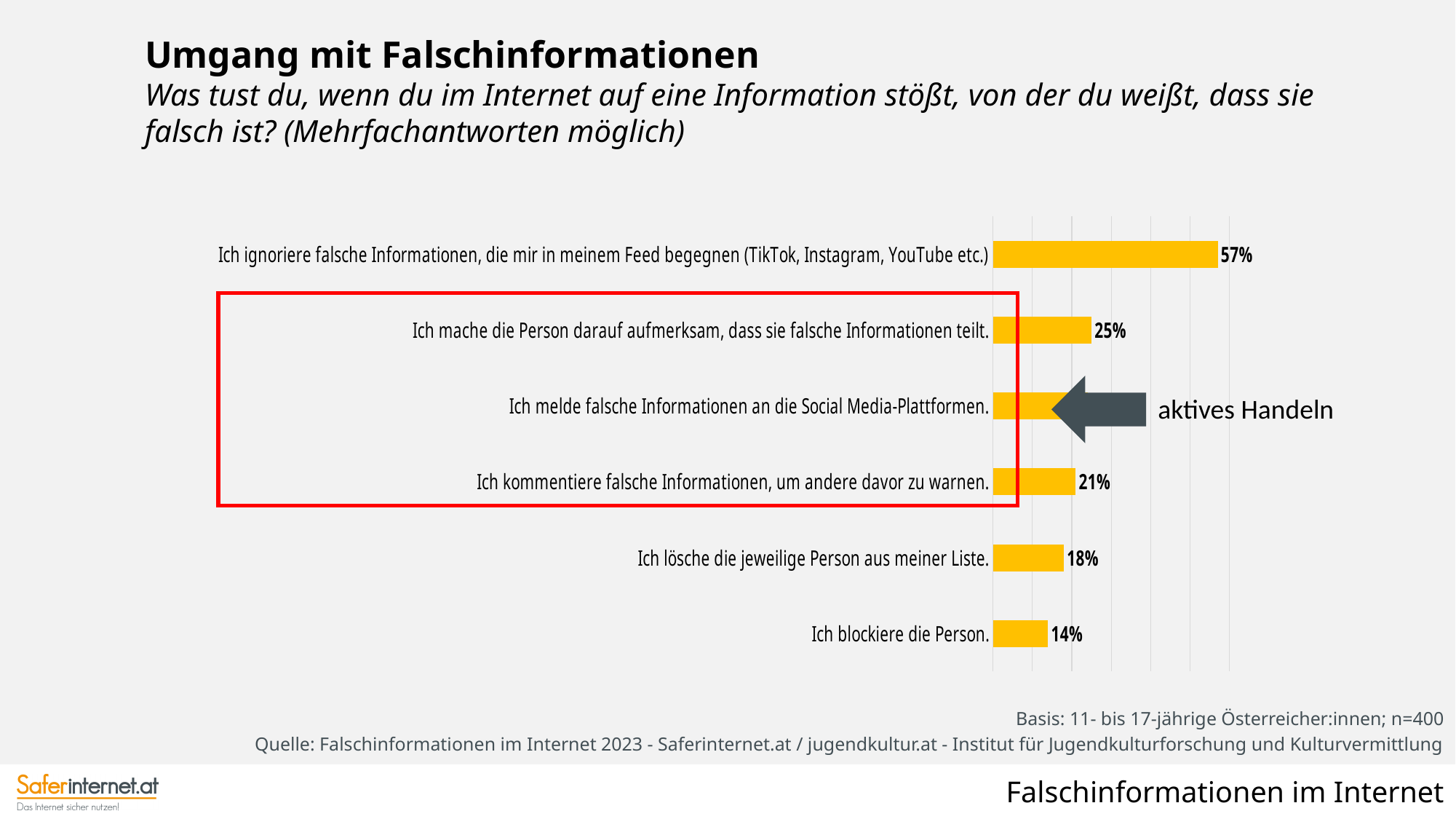
Which response has the lowest percentage? Ich blockiere die Person. What is the value for "Ich lösche die jeweilige Person aus meiner Liste."? 18% What percentage of respondents comment on false information to warn others? 21% What is the value for "Ich mache die Person darauf aufmerksam, dass sie falsche Informationen teilt."? 25% What percentage of respondents block the person? 14% How many response categories are shown in the chart? 6 How many percentage points higher is ignoring false information (57%) than making the person aware (25%)? 32 percentage points What percentage of respondents say they ignore false information they encounter in their feed (TikTok, Instagram, YouTube etc.)? 57% Which response has the highest percentage? Ich ignoriere falsche Informationen, die mir in meinem Feed begegnen (TikTok, Instagram, YouTube etc.) Which is larger: the share who delete the person from their list or the share who block the person? Ich lösche die jeweilige Person aus meiner Liste. What type of chart is shown on the slide? Bar chart What label does the grey arrow next to the red box carry? aktives Handeln